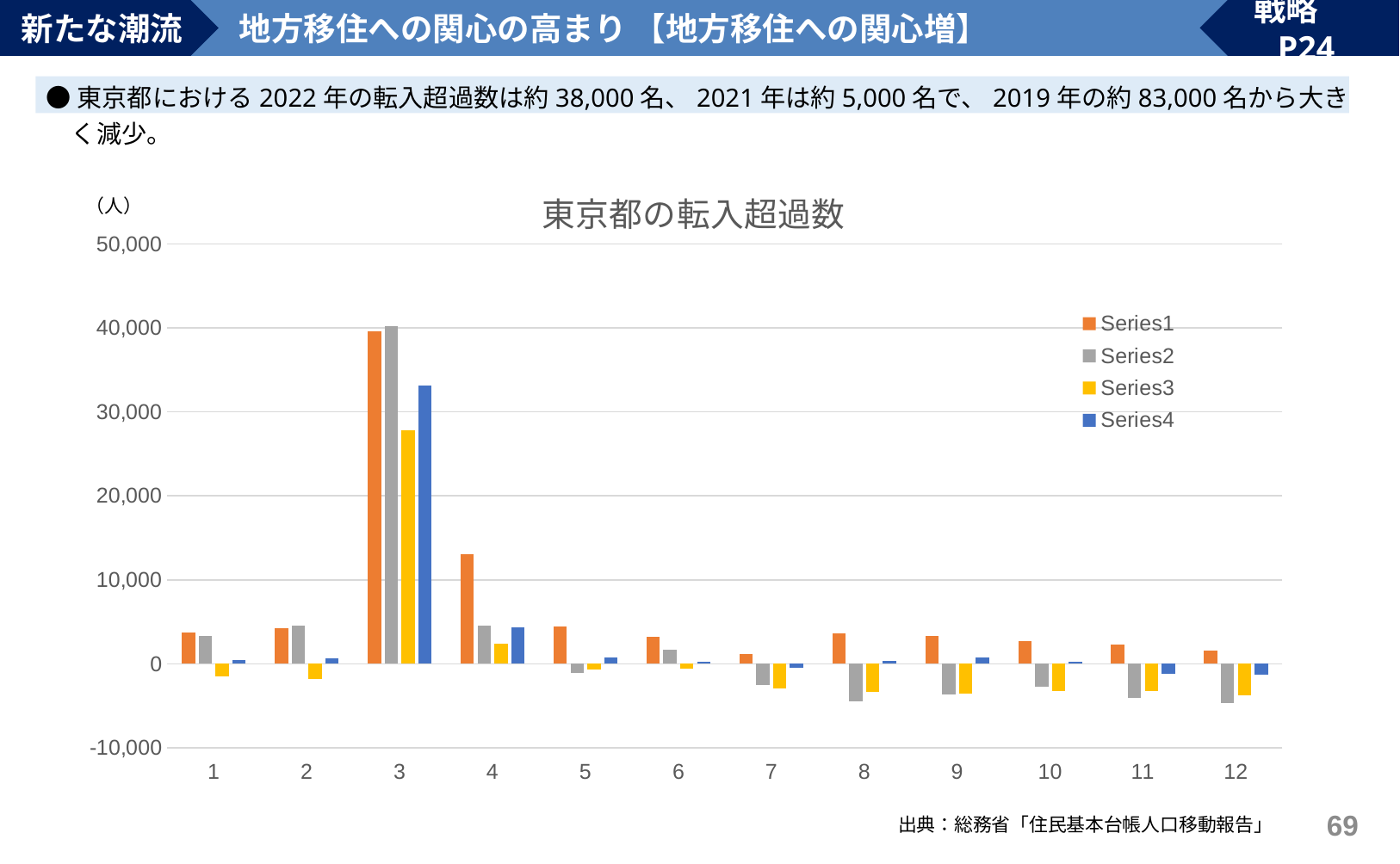
Which category on the x axis has the highest bars in the chart? 3 How many categories are shown on the x axis of the chart? 12 At category 3, which series has the lowest value? Series3 What colour represents Series3 in the chart's legend? yellow What kind of chart is shown on the slide? bar chart Is the value for Series3 at category 3 greater or less than 30,000? less Is the value for Series1 at category 3 greater or less than 30,000? greater Is the value for Series1 at category 4 greater or less than 10,000? greater What is the title of the chart? 東京都の転入超過数 How many series does the chart's legend list? 4 At category 3, which is larger: the value for Series1 or the value for Series3? Series1